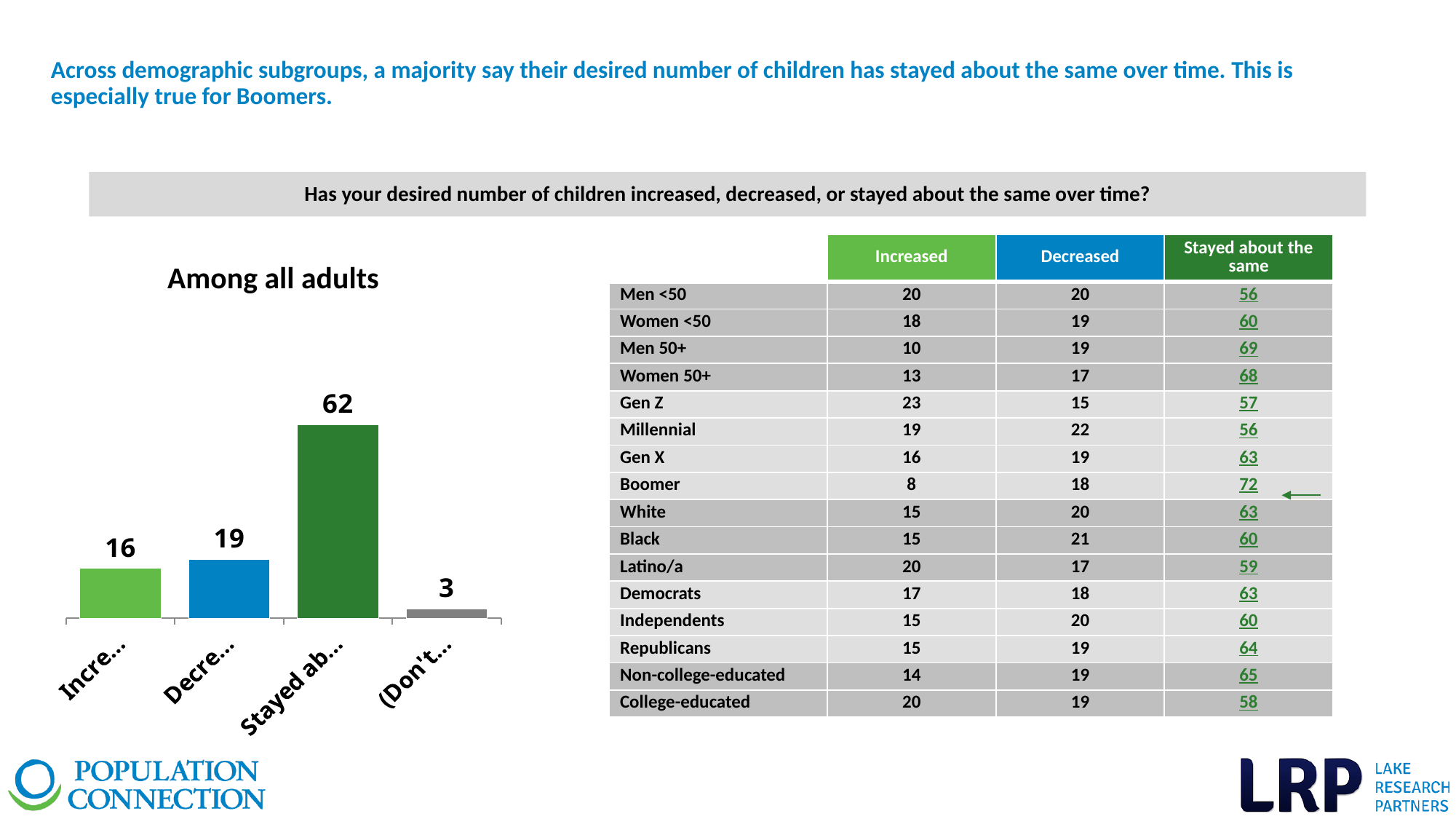
In the 'Among all adults' chart, what is the value for the 'Stayed about the same' bar? 62 What is the title of the chart on the left of the slide? Among all adults In the 'Among all adults' chart, what is the value for the 'Decreased' bar? 19 In the 'Among all adults' chart, which is larger, the 'Increased' bar or the 'Decreased' bar? Decreased In the 'Among all adults' chart, which category has the highest value? Stayed about the same In the 'Among all adults' chart, what is the value for the '(Don't know)' bar? 3 What type of chart is the 'Among all adults' chart? Bar chart In the 'Among all adults' chart, what is the difference between the 'Decreased' value and the 'Increased' value? 3 In the 'Among all adults' chart, which category has the lowest value? (Don't know) In the 'Among all adults' chart, what is the difference between the 'Stayed about the same' value and the 'Decreased' value? 43 In the 'Among all adults' chart, what is the value for the 'Increased' bar? 16 How many bars are shown in the 'Among all adults' chart? 4